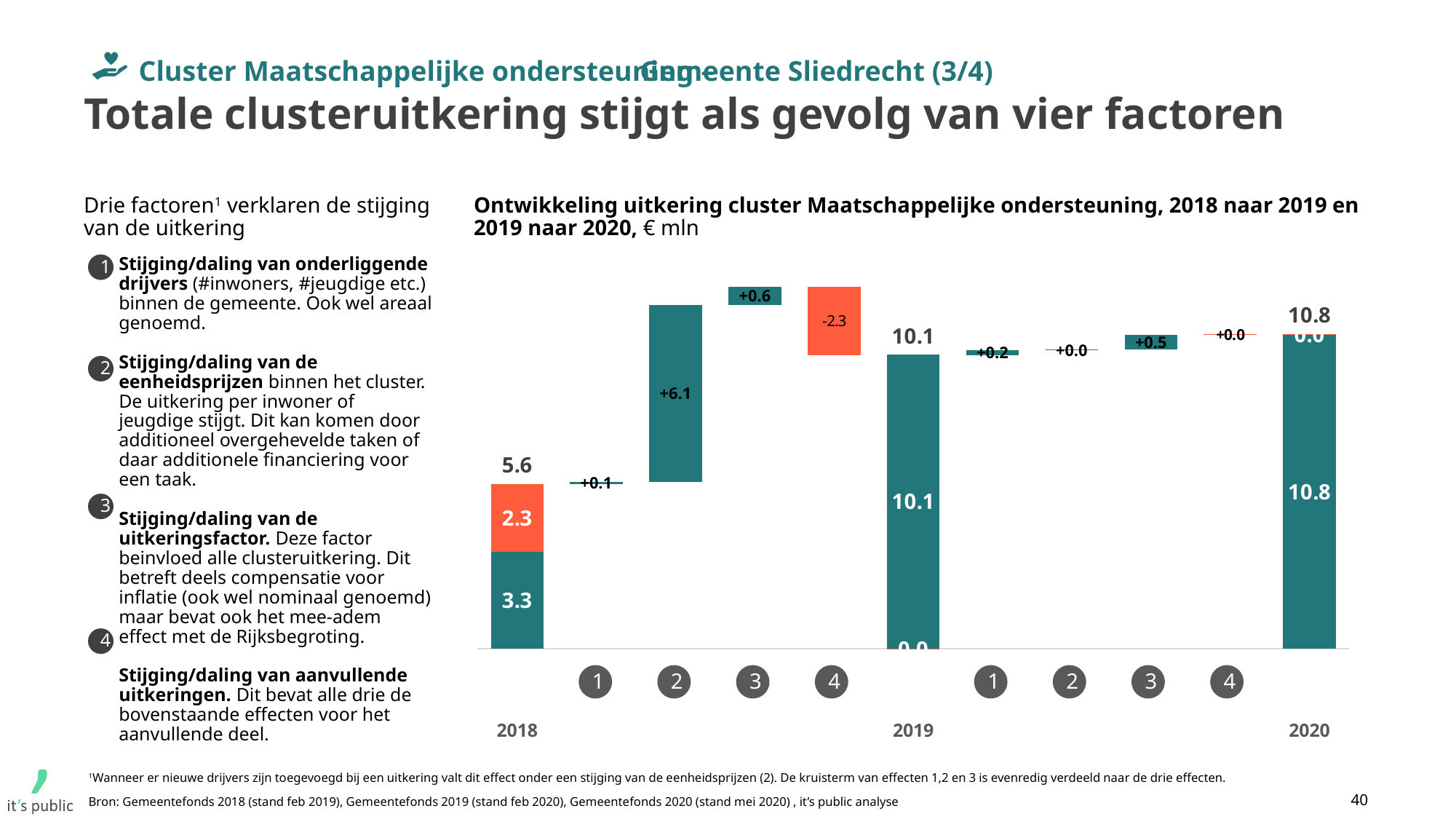
What is the total uitkering shown for 2018 in the chart? 5.6 What kind of chart is shown on the slide? Waterfall bar chart In what unit are the values in the chart expressed, according to the chart title? € mln Which of the four factors has the largest effect in the step from 2018 to 2019? Factor 2 (+6.1) What is the value of factor 3 (uitkeringsfactor) in the step from 2019 to 2020? +0.5 What is the total uitkering shown for 2019 in the chart? 10.1 What is the value of factor 4 (aanvullende uitkeringen) in the step from 2018 to 2019? -2.3 What is the difference between the 2019 total and the 2018 total? 4.5 What is the difference between the 2020 total and the 2019 total? 0.7 What is the value of factor 2 (eenheidsprijzen) in the step from 2018 to 2019? +6.1 What is the total uitkering shown for 2020 in the chart? 10.8 Which is larger: the 2018 total or the 2020 total? 2020 total